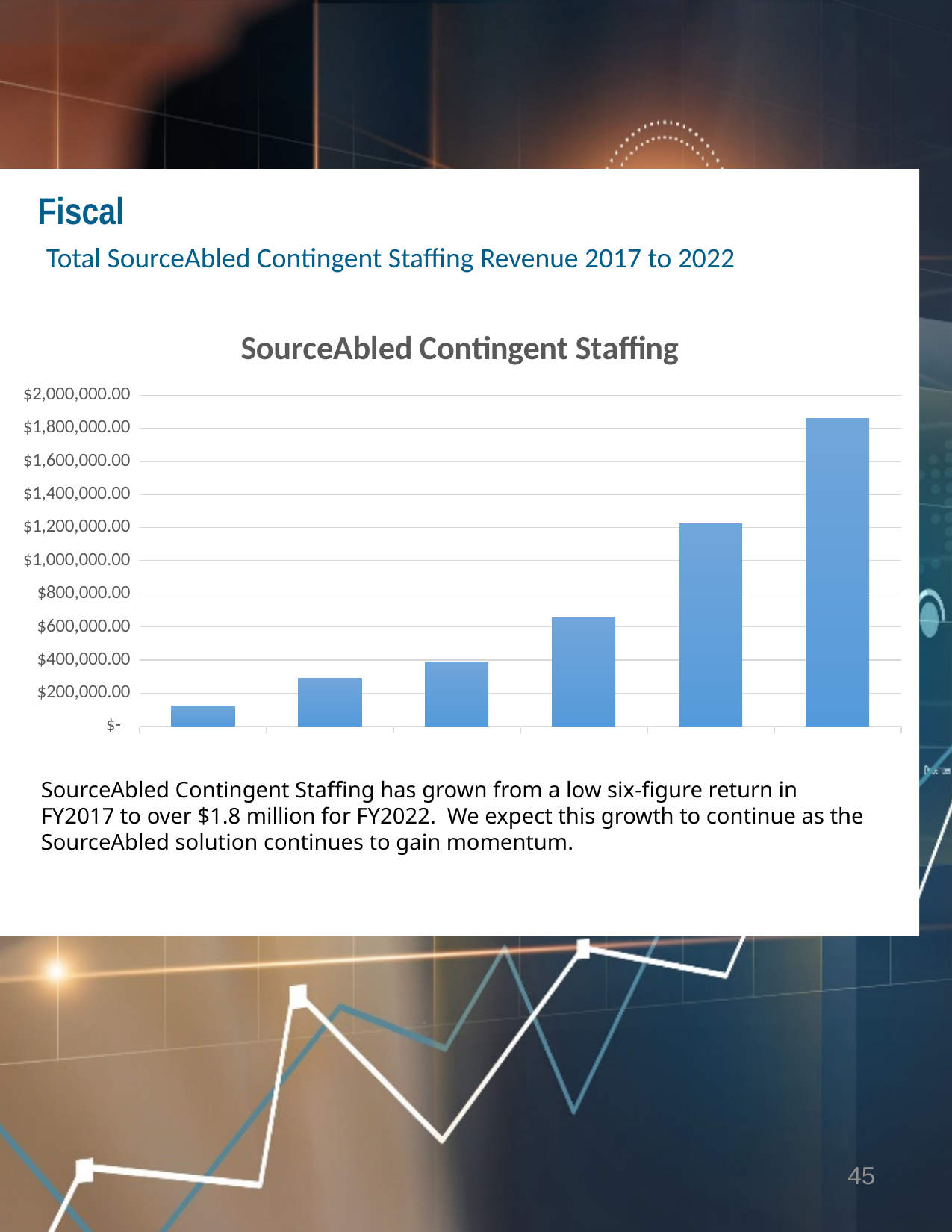
Which bar is the highest in the chart? the rightmost (sixth) bar What is the title of the chart? SourceAbled Contingent Staffing Is the value of the leftmost bar greater or less than $200,000.00? less What kind of chart is shown on the slide? bar chart How many bars are plotted in the SourceAbled Contingent Staffing chart? 6 Which is larger, the fourth bar or the fifth bar from the left? the fifth bar Which bar is the lowest in the chart? the leftmost (first) bar Is the value of the fourth bar from the left greater or less than $800,000.00? less Do the bar values rise or fall from left to right across the chart? rise Is the value of the rightmost bar greater or less than $1,600,000.00? greater